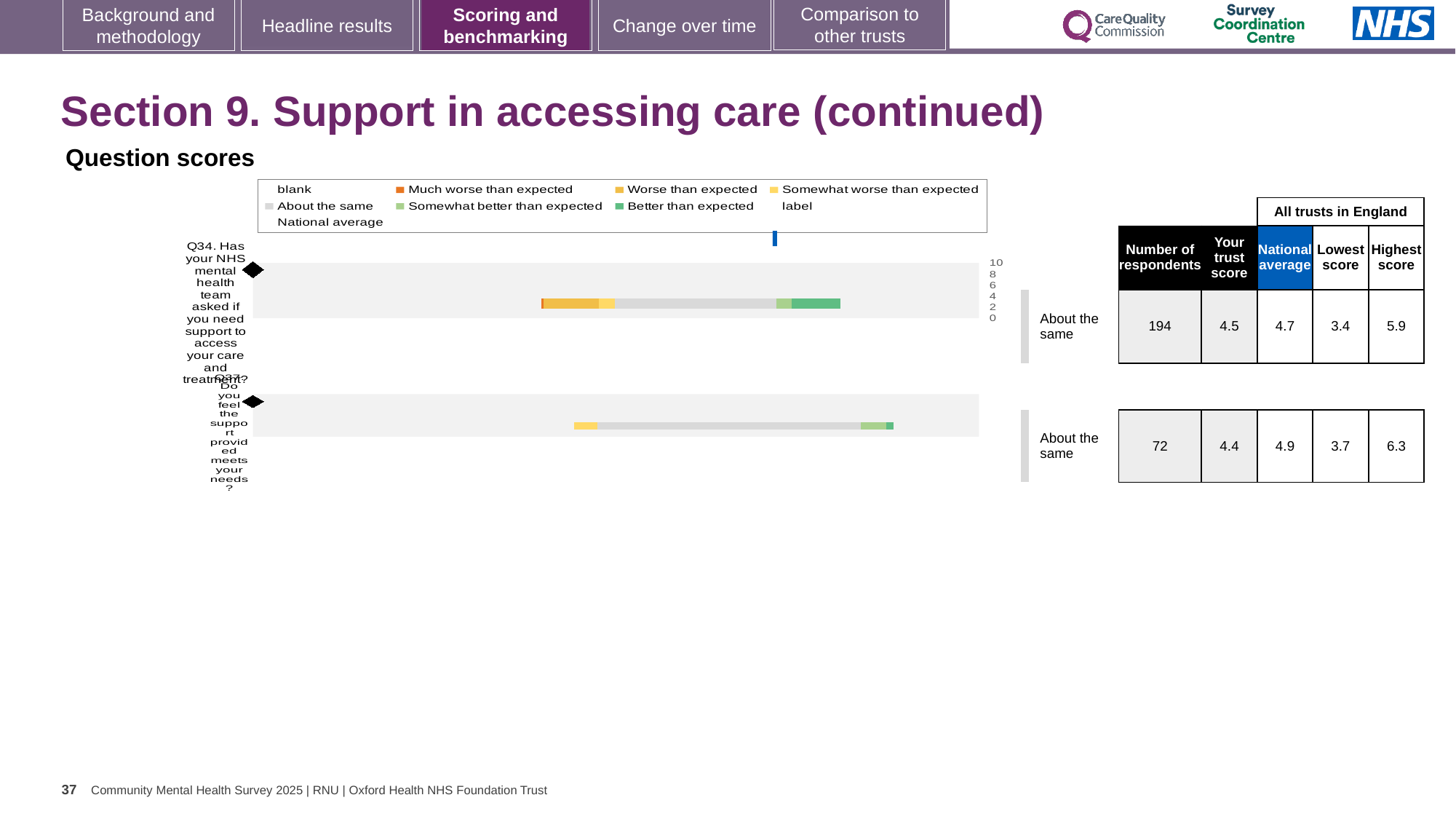
In the chart legend, which category is shown in orange? Much worse than expected What benchmark category is shown for Q34 in the question scores chart? About the same What is the title shown above the question scores chart? Question scores Which question has more respondents, Q34 or Q37? Q34 What is the difference between the highest score and the lowest score for Q34? 2.5 What is the national average for Q37? 4.9 What is the highest score among all trusts in England for Q37? 6.3 How many questions are plotted in the question scores chart? 2 What is the number of respondents for Q34? 194 What kind of chart is used to show the question scores on this slide? bar chart What benchmark category is shown for Q37 in the question scores chart? About the same What is your trust score for Q34? 4.5